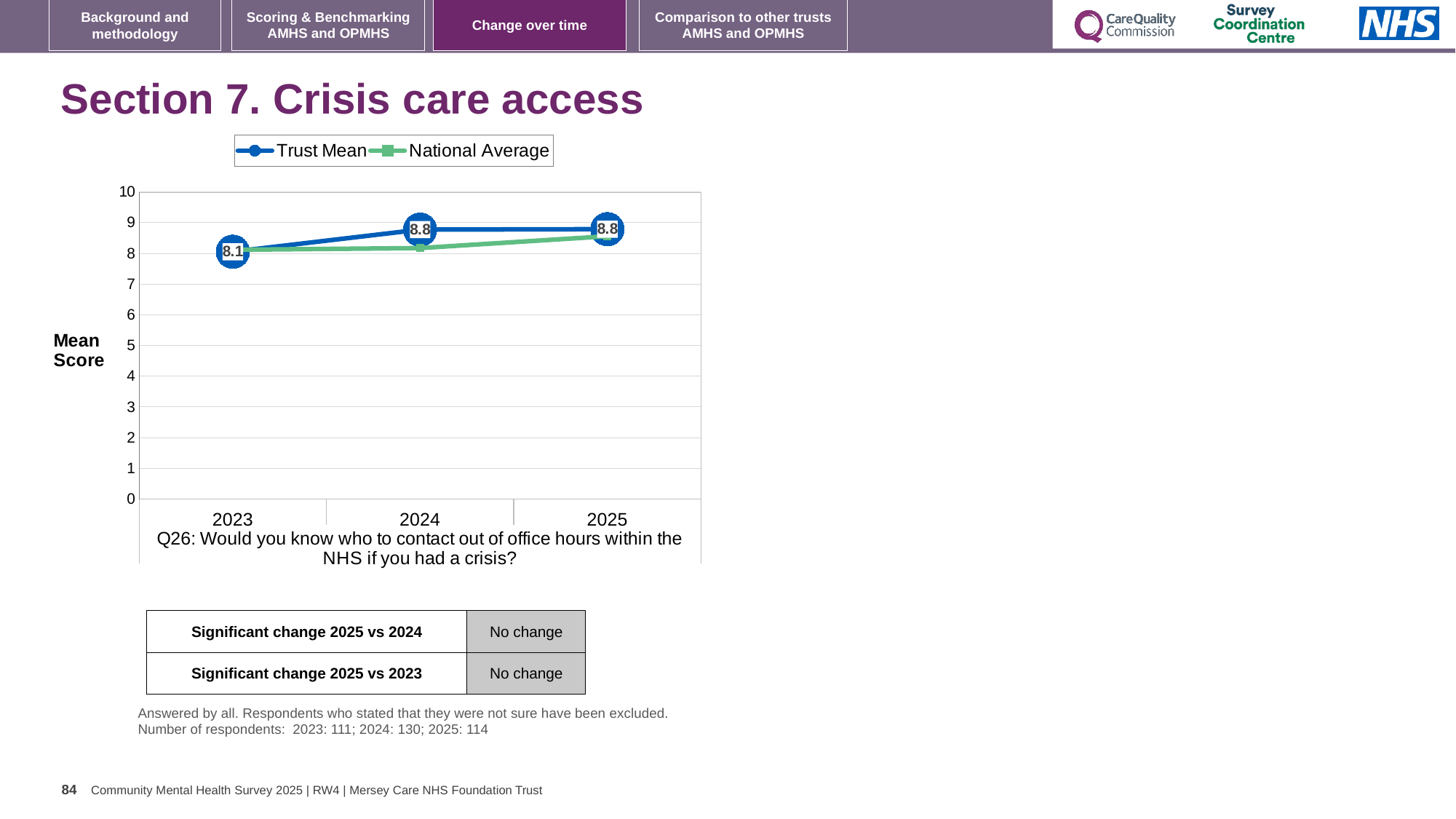
How many years are shown on the x axis? 3 What is the difference between the Trust Mean in 2024 and in 2023? 0.7 What kind of chart is shown on the slide? line chart What is the Trust Mean for 2025? 8.8 Which is larger, the Trust Mean in 2023 or in 2024? 2024 How many series does the legend list? 2 Does the Trust Mean rise or fall from 2023 to 2025? rise Is the National Average for 2025 greater or less than 8? greater In 2024, which series has the higher value, Trust Mean or National Average? Trust Mean In which year is the Trust Mean lowest? 2023 What is the Trust Mean for 2023? 8.1 What is the Trust Mean for 2024? 8.8